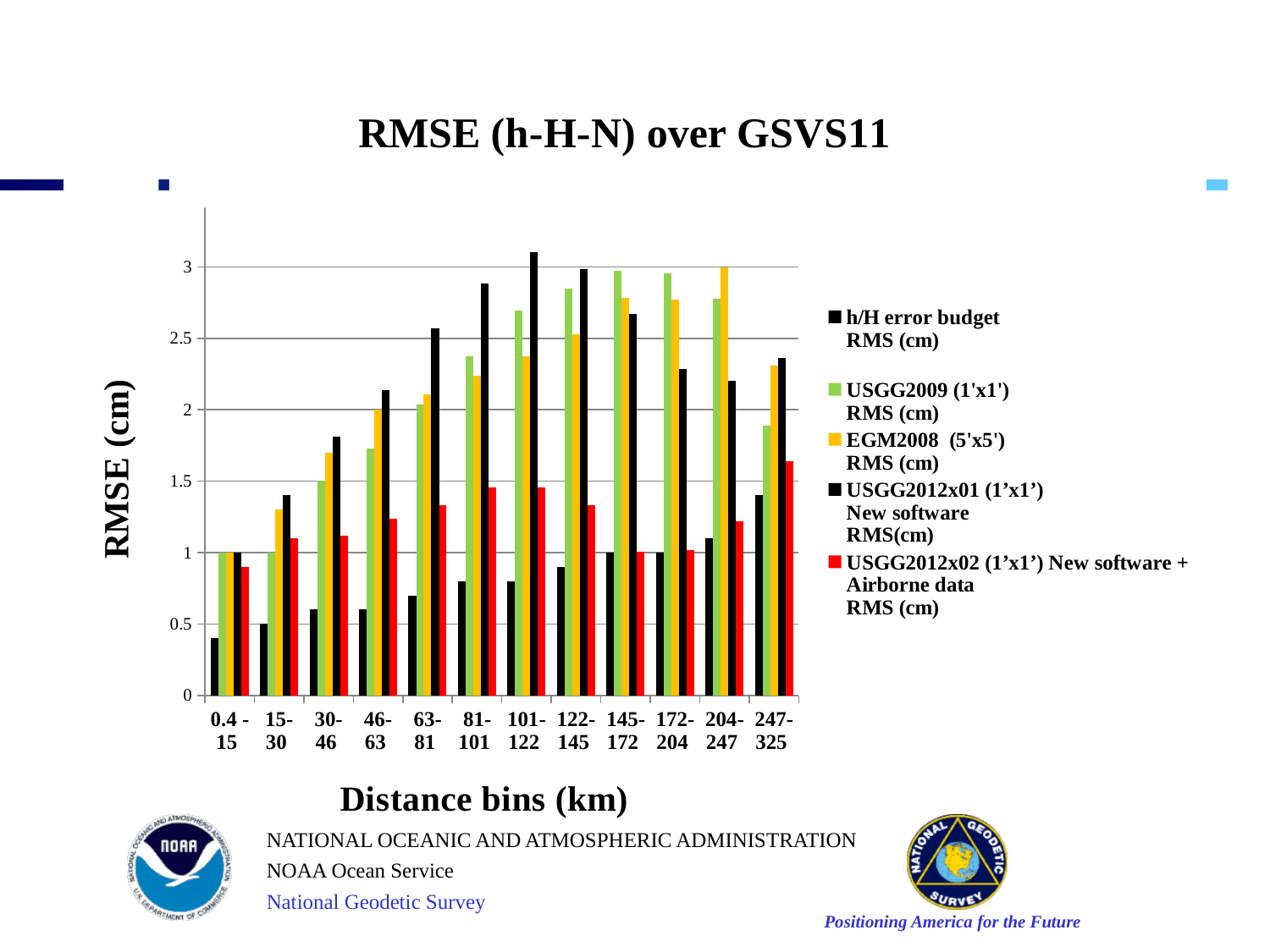
Is the h/H error budget RMS value for the 0.4-15 km bin greater or less than 0.5? less How many distance bins are shown along the x axis? 12 Is the USGG2012x01 (1'x1') New software RMS value for the 101-122 km bin greater or less than 3? greater What kind of chart is shown on the slide? bar chart Does the h/H error budget RMS generally rise or fall as the distance bins increase along the x axis? rise In which distance bin is the h/H error budget RMS value lowest? 0.4-15 What is the title of the chart? RMSE (h-H-N) over GSVS11 In which distance bin does the USGG2012x01 (1'x1') New software series reach its highest RMS value? 101-122 In the 101-122 km bin, which is larger: the USGG2012x01 (1'x1') New software RMS or the USGG2012x02 (1'x1') New software + Airborne data RMS? USGG2012x01 (1'x1') New software RMS How many series does the legend list? 5 Is the USGG2012x02 (1'x1') New software + Airborne data RMS value for the 247-325 km bin greater or less than 1.5? greater